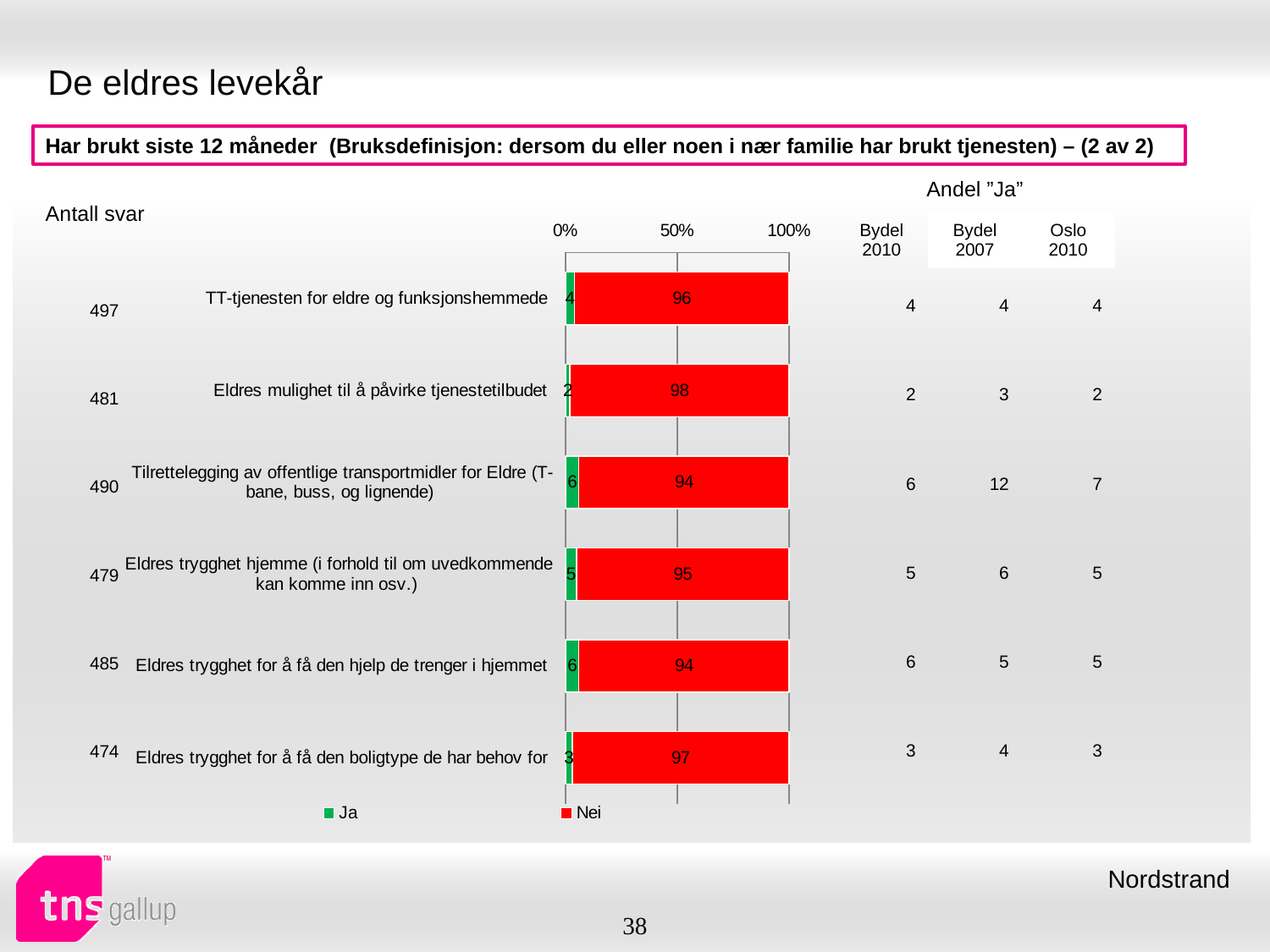
Which category has the highest "Nei" value? Eldres mulighet til å påvirke tjenestetilbudet What is the "Nei" value for "Eldres mulighet til å påvirke tjenestetilbudet"? 98 How many series does the legend list? 2 Which is larger: the "Nei" value for "TT-tjenesten for eldre og funksjonshemmede" or for "Eldres trygghet for å få den hjelp de trenger i hjemmet"? TT-tjenesten for eldre og funksjonshemmede What is the "Nei" value for "TT-tjenesten for eldre og funksjonshemmede"? 96 How many categories are shown in the chart? 6 What kind of chart is shown on the slide? Stacked bar chart What is the difference between the "Nei" values for "Eldres mulighet til å påvirke tjenestetilbudet" and "Eldres trygghet hjemme (i forhold til om uvedkommende kan komme inn osv.)"? 3 What is the "Nei" value for "Eldres trygghet for å få den boligtype de har behov for"? 97 What is the "Ja" value for "Tilrettelegging av offentlige transportmidler for Eldre (T-bane, buss, og lignende)"? 6 Which category has the lowest "Nei" value? Tilrettelegging av offentlige transportmidler for Eldre (T-bane, buss, og lignende) and Eldres trygghet for å få den hjelp de trenger i hjemmet (both 94) Is the "Nei" value for "Eldres trygghet hjemme (i forhold til om uvedkommende kan komme inn osv.)" greater or less than 50%? greater